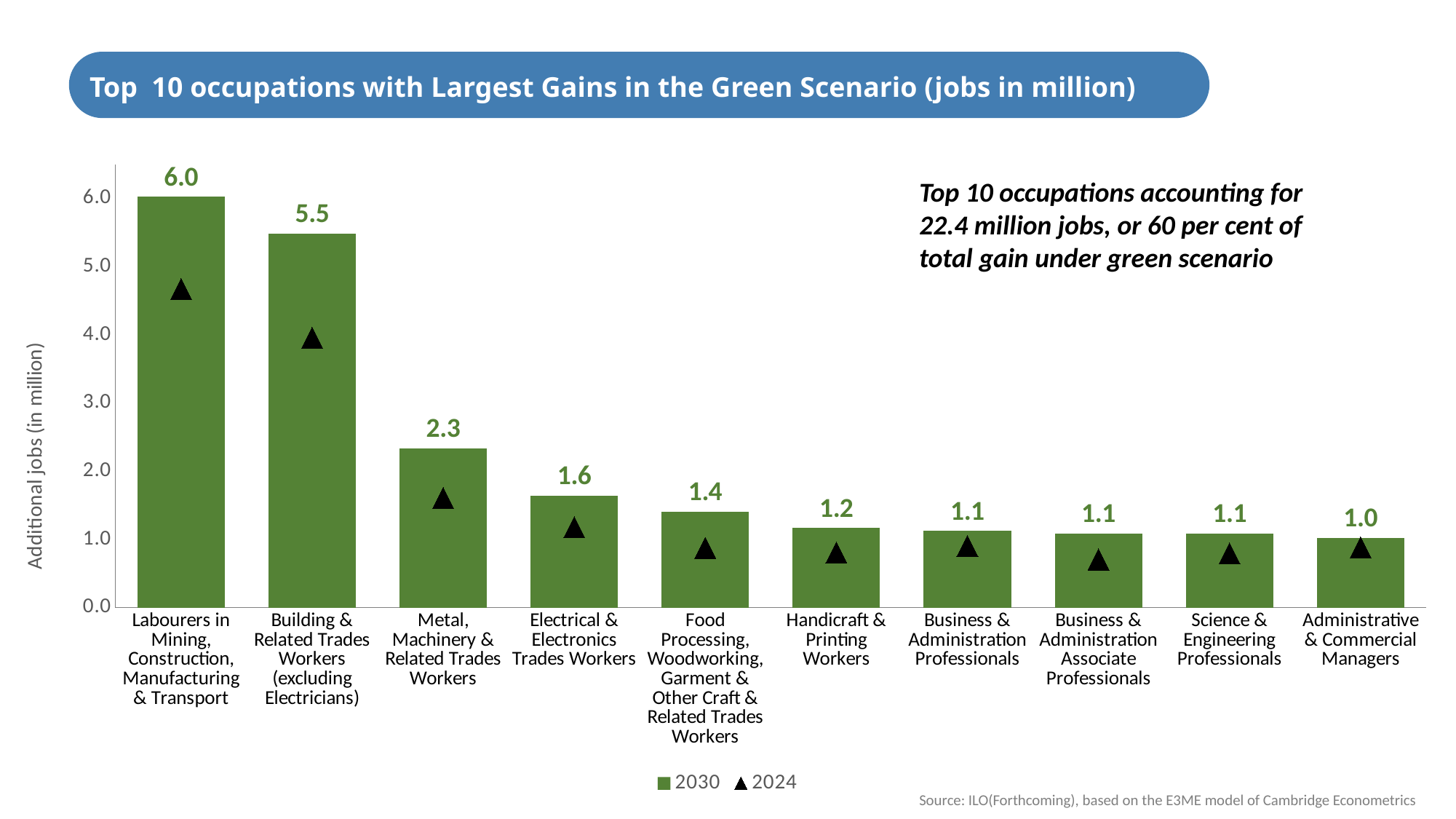
Which occupation has the lowest 2030 value? Administrative & Commercial Managers What is the 2030 value for Building & Related Trades Workers (excluding Electricians)? 5.5 What is the 2030 value for Metal, Machinery & Related Trades Workers? 2.3 Which has a larger 2030 value: Metal, Machinery & Related Trades Workers or Electrical & Electronics Trades Workers? Metal, Machinery & Related Trades Workers How many series does the legend list? 2 What is the 2030 value for Handicraft & Printing Workers? 1.2 Is the 2024 value for Labourers in Mining, Construction, Manufacturing & Transport greater or less than 4.0? greater What is the 2030 value for Labourers in Mining, Construction, Manufacturing & Transport? 6.0 What kind of chart is shown on the slide? bar chart Which occupation has the highest 2030 value? Labourers in Mining, Construction, Manufacturing & Transport How many occupations are shown on the chart? 10 What is the difference between the 2030 values for Labourers in Mining, Construction, Manufacturing & Transport and Building & Related Trades Workers (excluding Electricians)? 0.5